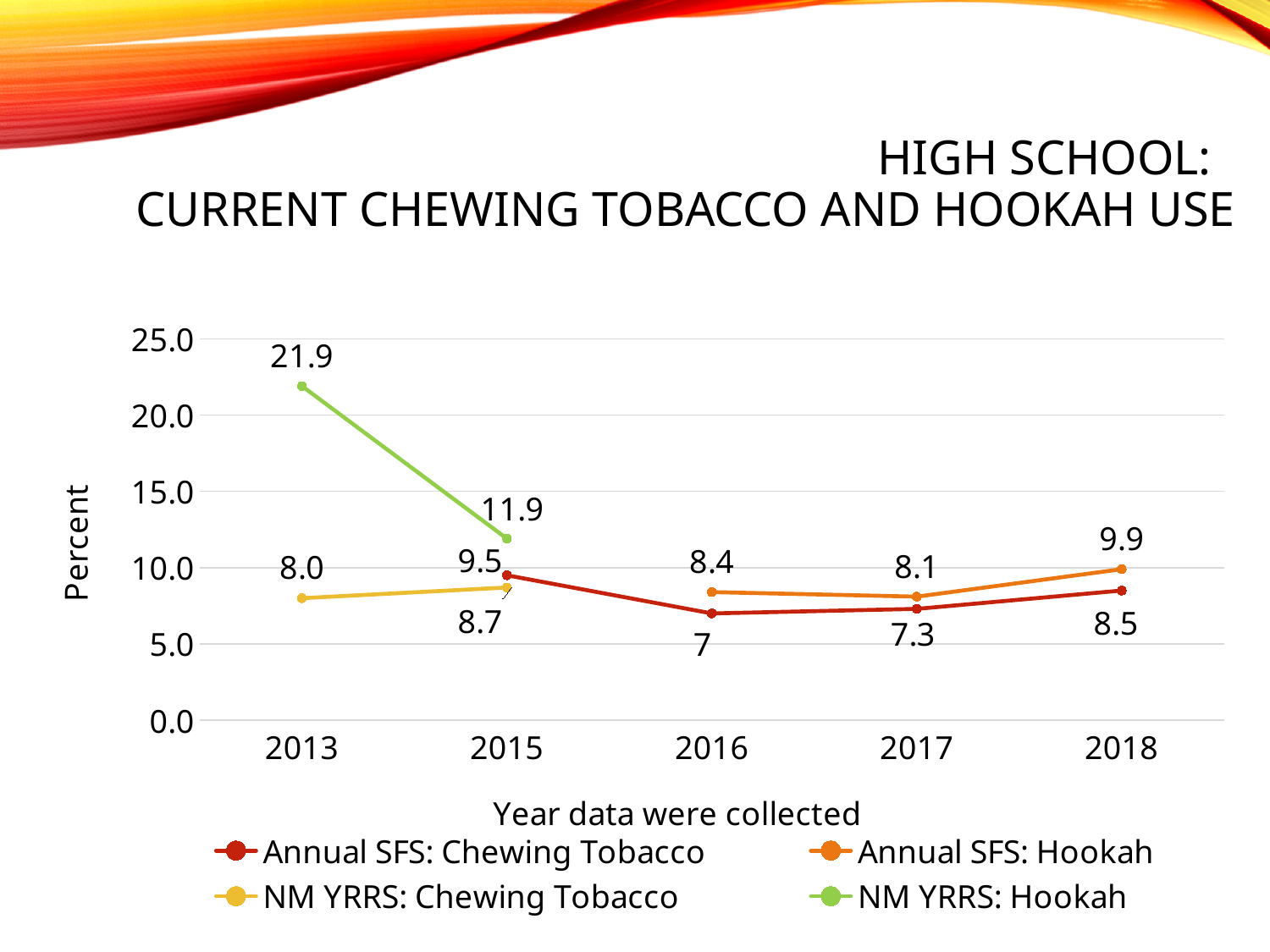
What is the value for NM YRRS: Hookah in 2013? 21.9 In which year is the Annual SFS: Chewing Tobacco value lowest? 2016 By how much did NM YRRS: Hookah fall from 2013 to 2015? 10.0 How many series does the legend list? 4 In 2017, which is larger: Annual SFS: Hookah or Annual SFS: Chewing Tobacco? Annual SFS: Hookah What is the value for Annual SFS: Hookah in 2018? 9.9 Which series and year has the highest value on the chart? NM YRRS: Hookah in 2013 How many years are shown on the x axis? 5 Does the NM YRRS: Hookah line rise or fall from 2013 to 2015? Fall What kind of chart is shown on the slide? Line chart What is the value for Annual SFS: Chewing Tobacco in 2016? 7 What is the value for NM YRRS: Chewing Tobacco in 2015? 8.7